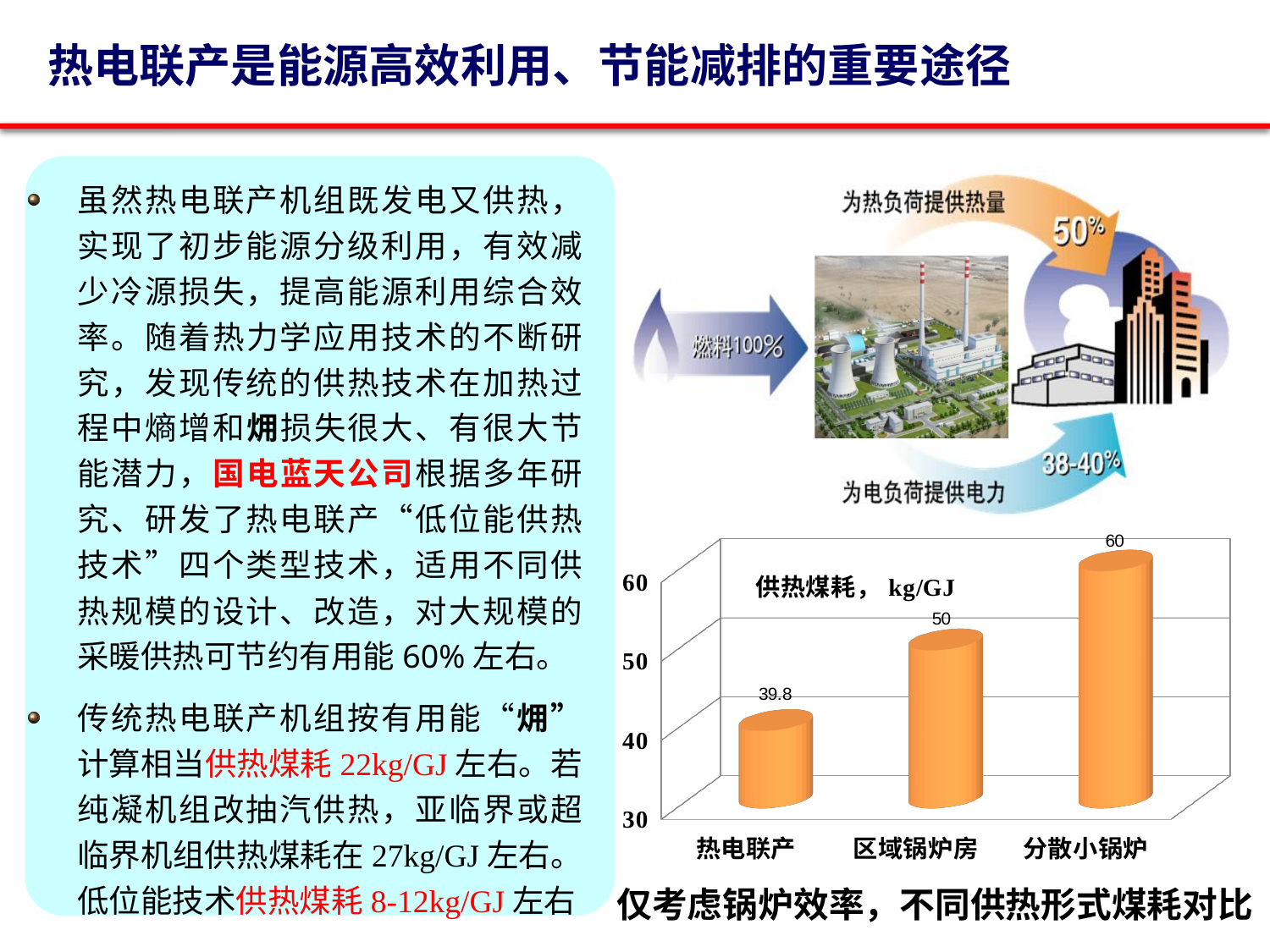
How many categories are shown in the bar chart? 3 Which category has the highest value in the bar chart? 分散小锅炉 What is the difference between the values for 分散小锅炉 and 热电联产? 20.2 Which is larger, the value for 区域锅炉房 or the value for 热电联产? 区域锅炉房 What unit is given in the chart's title label? kg/GJ Which category has the lowest value in the bar chart? 热电联产 What is the difference between the values for 区域锅炉房 and 热电联产? 10.2 What is the value for 区域锅炉房 in the bar chart? 50 What is the value for 热电联产 in the bar chart? 39.8 What kind of chart is shown on the slide? bar chart Is the value for 热电联产 greater or less than 40? less What is the value for 分散小锅炉 in the bar chart? 60